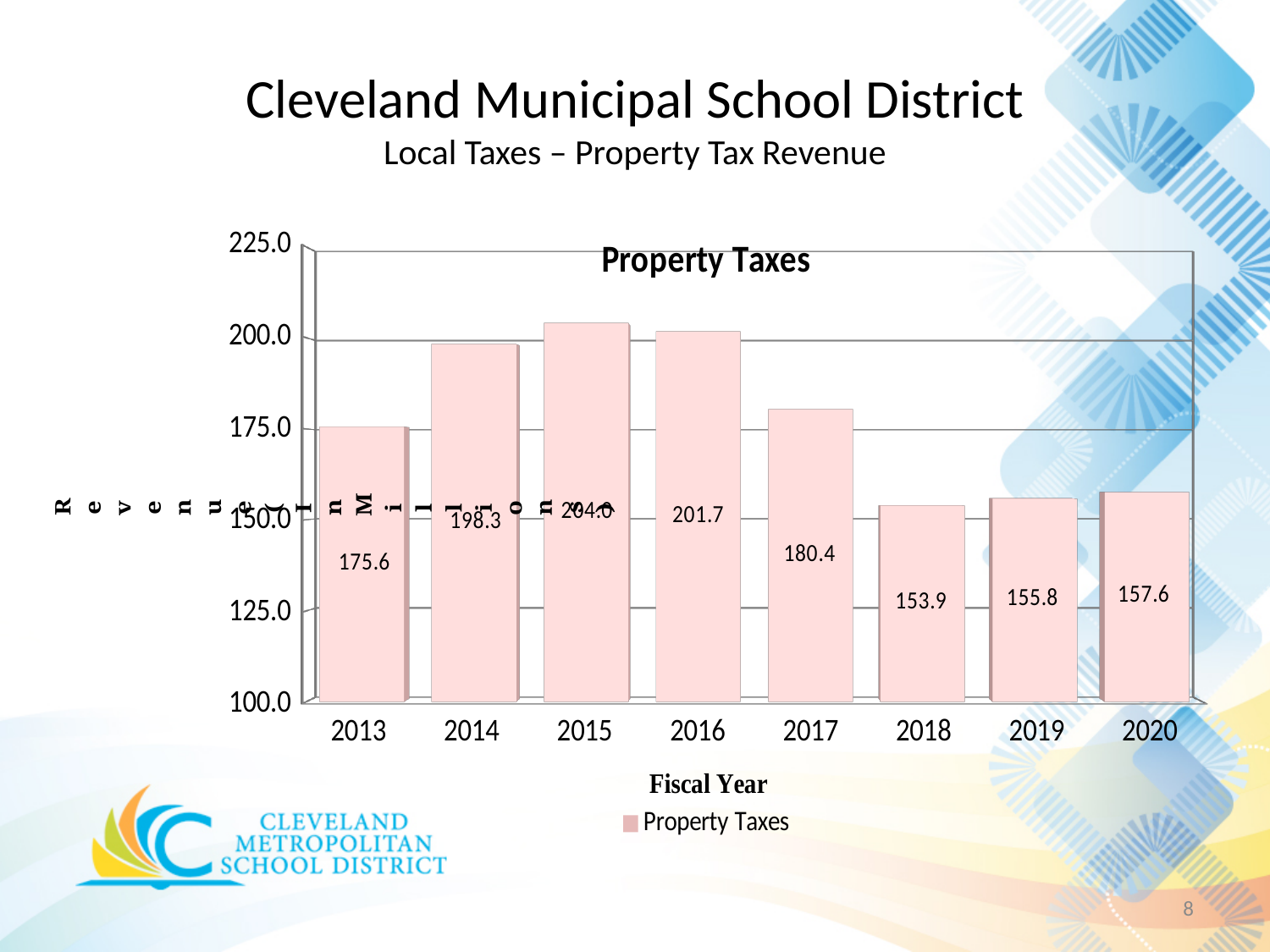
Is the value for 2015 greater or less than 200.0? greater Which fiscal year has the highest property tax revenue? 2015 What is the property tax revenue for fiscal year 2013? 175.6 What type of chart is shown on the slide? bar chart What is the property tax revenue for fiscal year 2018? 153.9 Which fiscal year has the lowest property tax revenue? 2018 How many fiscal years are shown on the x axis? 8 Which fiscal year has higher property tax revenue, 2017 or 2019? 2017 What is the title of the chart? Property Taxes What is the difference between the property tax revenue in 2014 and in 2013? 22.7 What is the property tax revenue for fiscal year 2016? 201.7 What is the property tax revenue for fiscal year 2020? 157.6